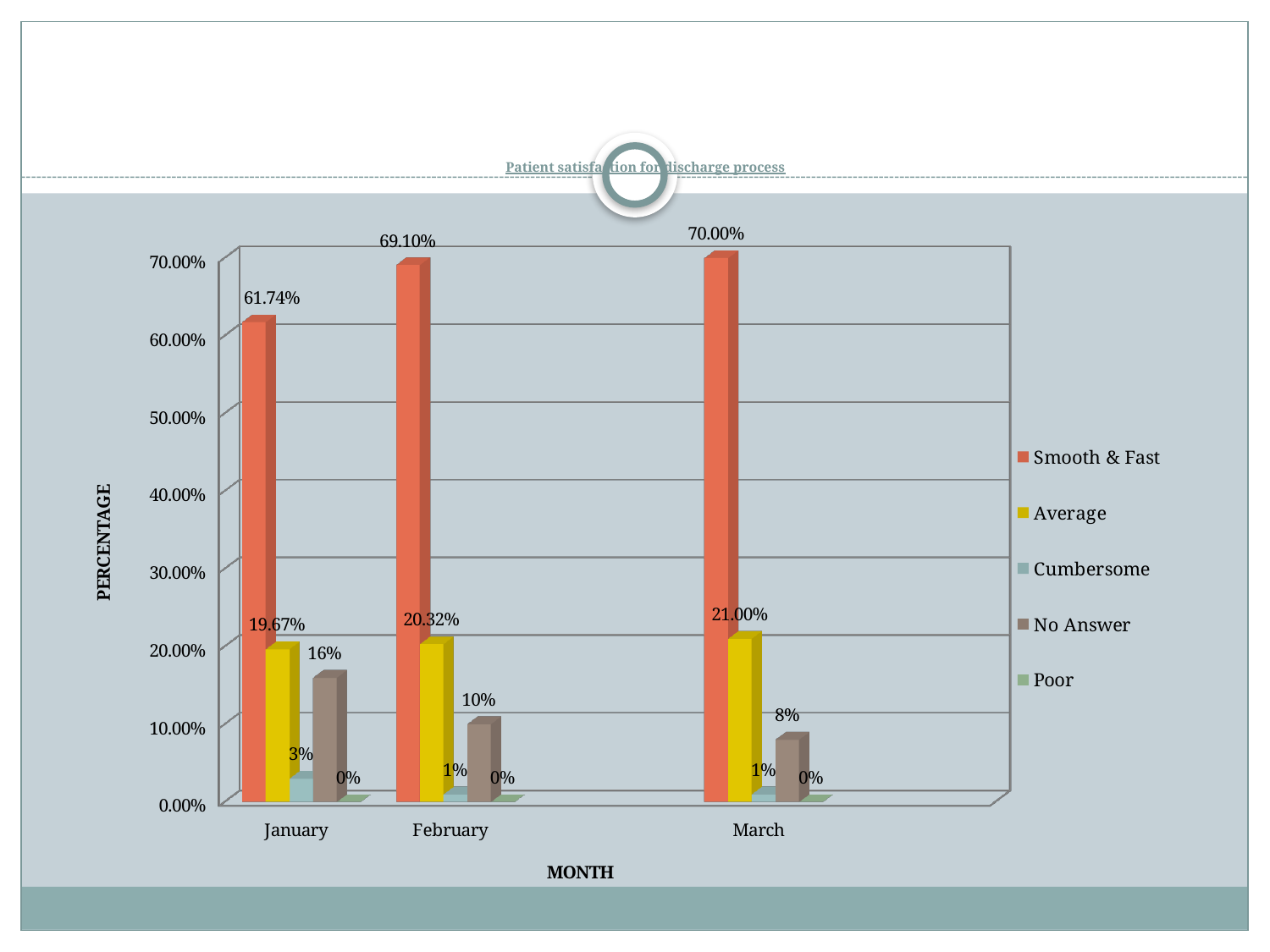
In which month is the No Answer value lowest? March In which month is the Smooth & Fast value highest? March What is the value for Smooth & Fast in January? 61.74% How many series does the legend list? 5 What is the value for No Answer in March? 8% What is the difference between the Smooth & Fast values for March and January? 8.26% Which is larger, the No Answer value for January or for February? January How many months are shown on the x axis? 3 What kind of chart is shown on the slide? Bar chart What is the value for Cumbersome in January? 3% What is the value for Average in February? 20.32% Does the Smooth & Fast value rise or fall from January to March? Rise